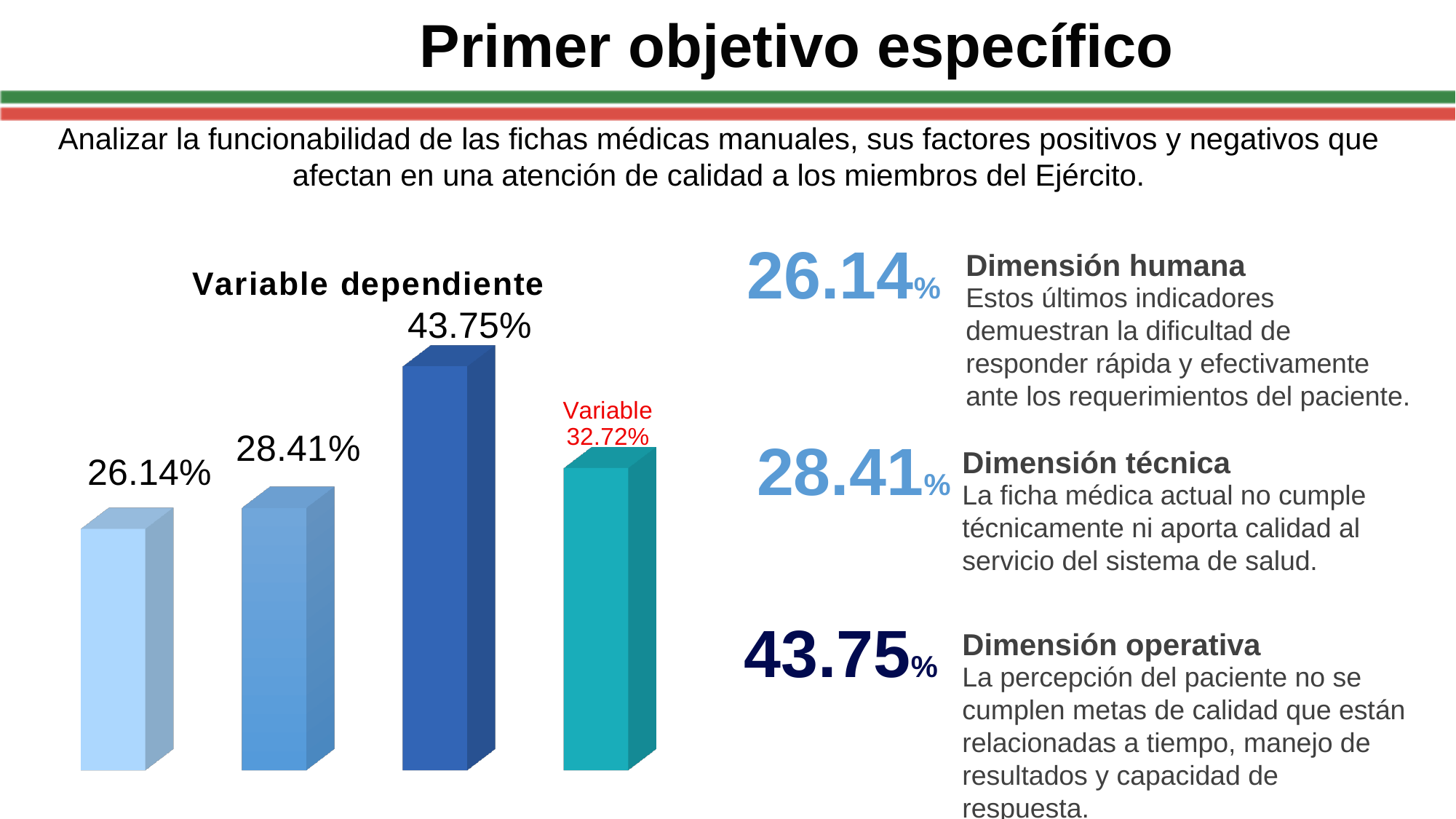
Which bar in the "Variable dependiente" chart has the highest value? the third bar (43.75%) How many bars are plotted in the "Variable dependiente" chart? 4 Which bar in the "Variable dependiente" chart has the lowest value? the first bar (26.14%) In the "Variable dependiente" chart, what is the difference between the highest bar (43.75%) and the lowest bar (26.14%)? 17.61% What value is labelled on the third bar of the "Variable dependiente" chart? 43.75% In the "Variable dependiente" chart, which is larger: the bar labelled 28.41% or the bar labelled "Variable 32.72%"? Variable 32.72% What value is labelled on the first (leftmost) bar of the "Variable dependiente" chart? 26.14% In the "Variable dependiente" chart, what colour is the bar labelled "Variable 32.72%"? teal What value is labelled on the bar marked "Variable" in the "Variable dependiente" chart? 32.72% What is the title of the chart on the slide? Variable dependiente What kind of chart is shown under the title "Variable dependiente"? bar chart What value is labelled on the second bar of the "Variable dependiente" chart? 28.41%